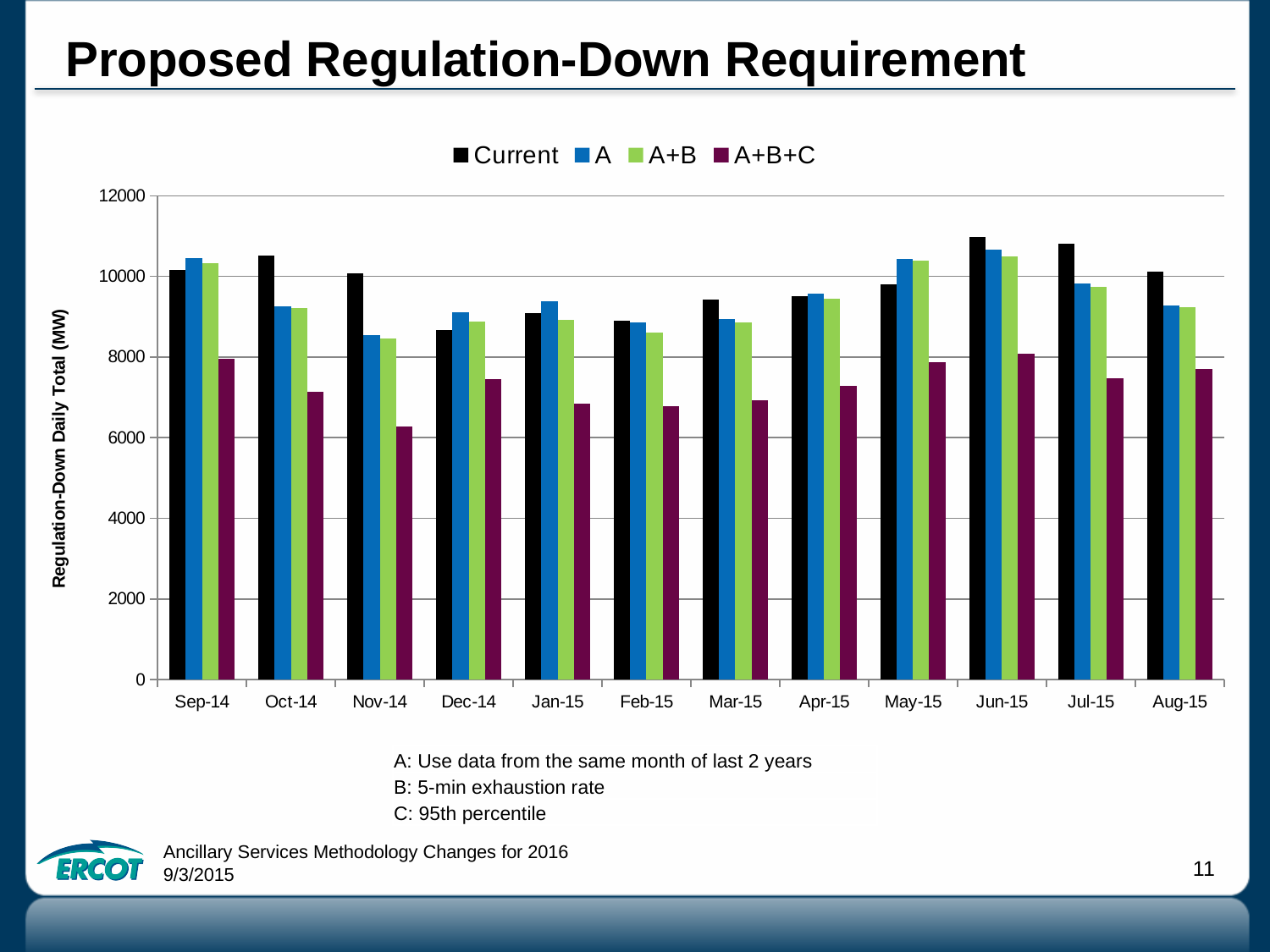
What is the title of the y axis? Regulation-Down Daily Total (MW) How many series does the legend list? 4 How many months are shown along the x axis? 12 Is the A value for Nov-14 greater or less than 10000? less Which month has the lowest A+B+C value? Nov-14 Is the Current value for Jun-15 greater or less than 10000? greater Which month has the highest Current value? Jun-15 What kind of chart is shown on the slide? Bar chart Which is larger, the Current value for Oct-14 or the Current value for Dec-14? Oct-14 Is the A+B+C value for Nov-14 greater or less than 8000? less In Oct-14, which is larger, the Current value or the A value? Current Which month has the lowest Current value? Dec-14